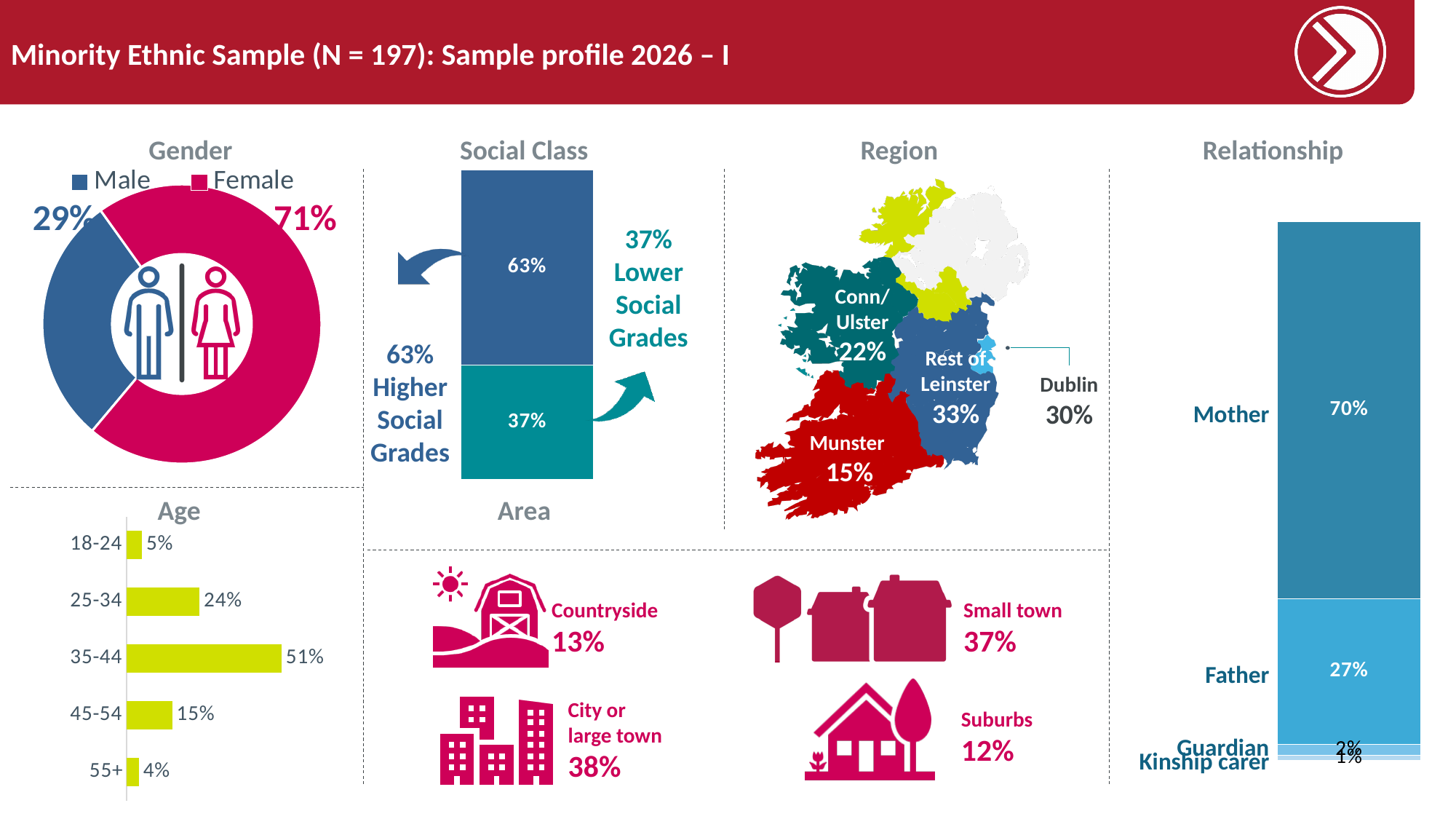
In the Gender chart, what percentage of the sample is Female? 71% In the Age chart, which age group has the highest percentage? 35-44 In the Relationship chart, which category has the largest share? Mother What kind of chart is the Gender chart? Pie (donut) chart In the Social Class chart, what percentage is in Higher Social Grades? 63% In the Relationship chart, what is the difference between Mother and Father? 43% In the Age chart, how many age groups are shown? 5 In the Age chart, what is the value for the 25-34 age group? 24% In the Age chart, which age group has the lowest percentage? 55+ In the Gender chart, what percentage of the sample is Male? 29% In the Relationship chart, what is the value for Father? 27% In the Age chart, what is the difference between the 35-44 and 45-54 age groups? 36%